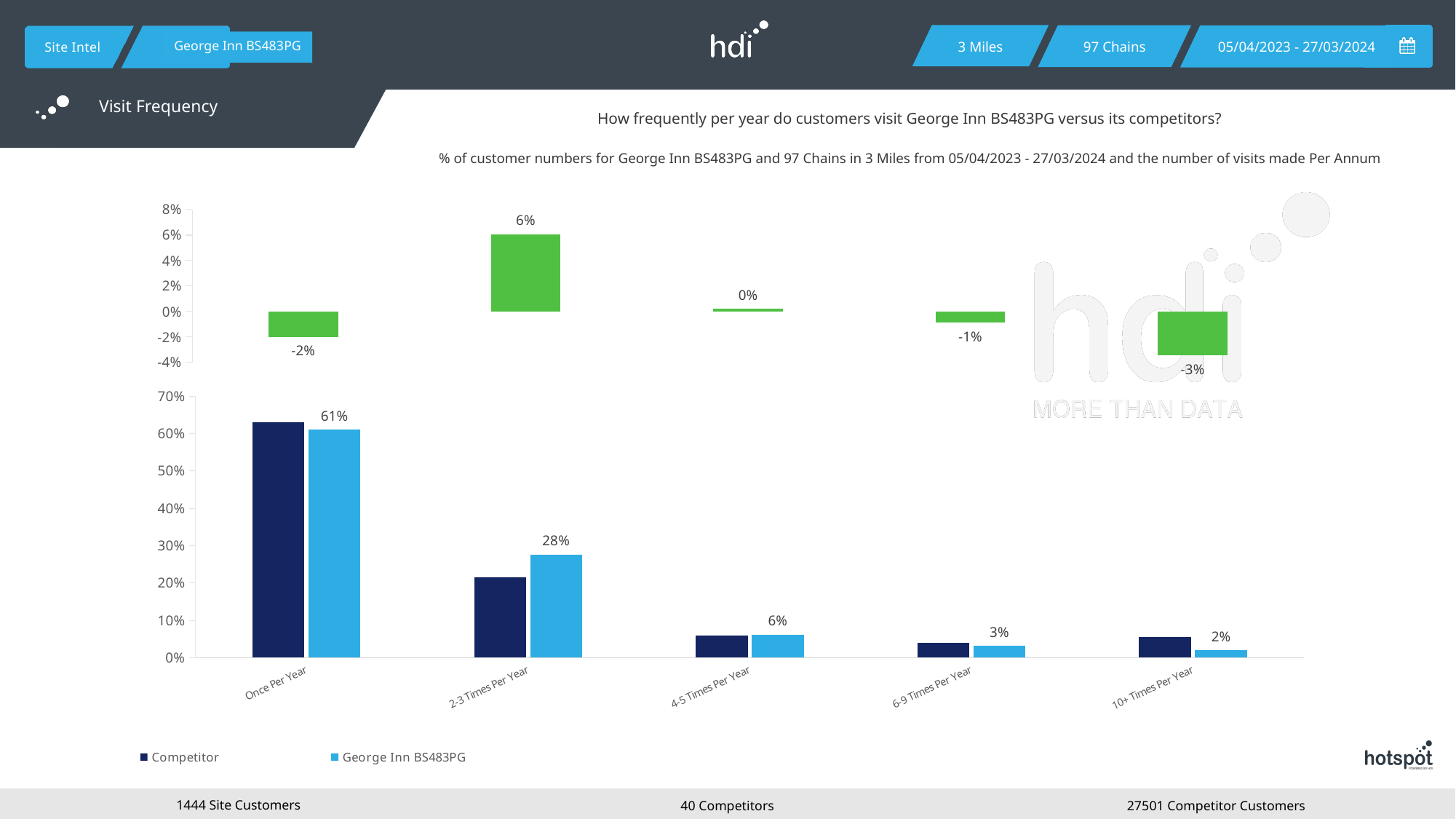
On the lower bar chart, which category has the highest value for George Inn BS483PG? Once Per Year On the lower bar chart, is the Competitor value for Once Per Year greater or less than 60%? greater How many series does the legend of the lower bar chart list? 2 On the upper chart, what is the value for 10+ Times Per Year? -3% On the lower bar chart, what is the value for George Inn BS483PG for 2-3 Times Per Year? 28% How many categories are shown on the x axis of the lower bar chart? 5 On the lower bar chart, what is the value for George Inn BS483PG for 10+ Times Per Year? 2% On the upper chart, what is the value for 2-3 Times Per Year? 6% On the lower bar chart, what is the value for George Inn BS483PG for Once Per Year? 61% On the lower bar chart, what is the difference between the George Inn BS483PG values for Once Per Year and 2-3 Times Per Year? 33% On the lower bar chart, for 2-3 Times Per Year, which is larger: Competitor or George Inn BS483PG? George Inn BS483PG On the lower bar chart, which category has the lowest value for George Inn BS483PG? 10+ Times Per Year